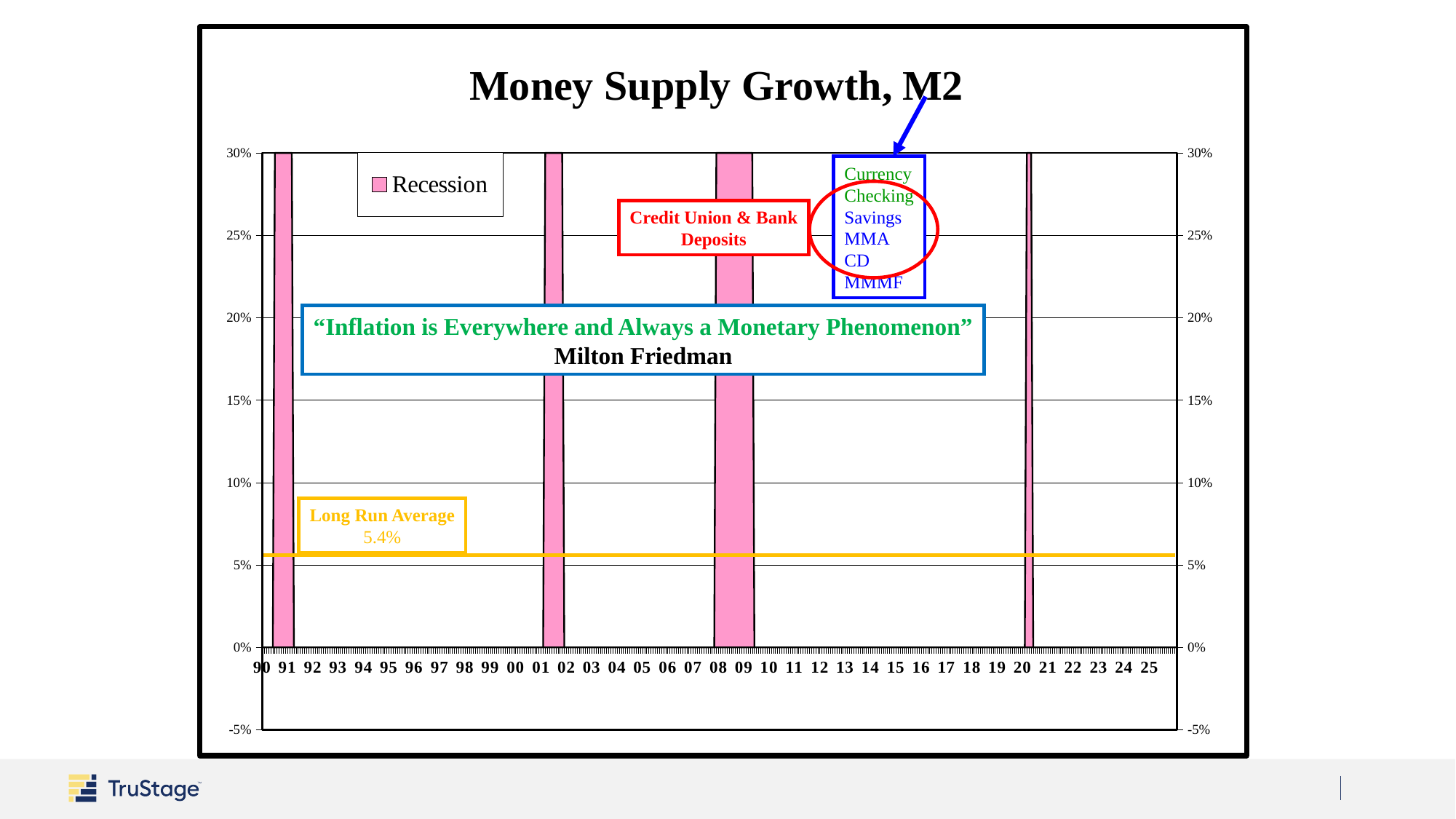
What is the first year label on the chart's horizontal axis? 90 What value is given for the Long Run Average in the chart? 5.4% Which shaded recession period on the chart is the narrowest? 20 Which shaded recession period on the chart is the widest? 08-09 What is the highest value shown on the chart's vertical axis? 30% What is the last year label on the chart's horizontal axis? 25 What is the only entry in the chart's legend? Recession What is the title of the chart? Money Supply Growth, M2 Is the Long Run Average line on the chart greater or less than 10%? less How many series does the chart's legend list? 1 What is the lowest value shown on the chart's vertical axis? -5% How many shaded recession periods are shown on the chart? 4